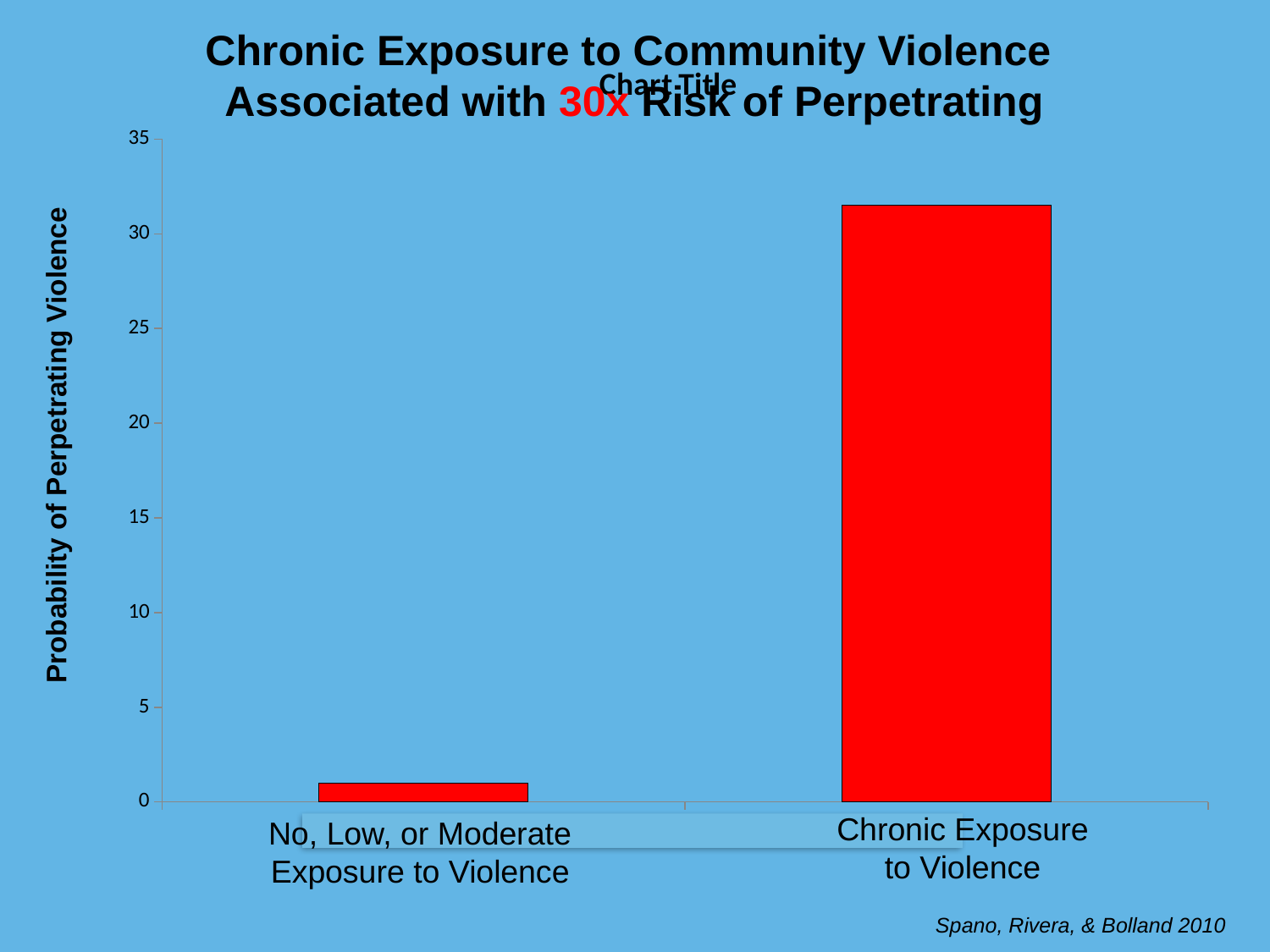
Is the value for No, Low, or Moderate Exposure to Violence greater or less than 5? less Is the value for Chronic Exposure to Violence greater or less than 30? greater How many categories are plotted on the x axis? 2 Which category has the lowest probability of perpetrating violence? No, Low, or Moderate Exposure to Violence Is the value for Chronic Exposure to Violence greater or less than 35? less What is the highest value shown on the vertical axis? 35 Do the values rise or fall moving from left to right along the x axis? rise What kind of chart is shown on the slide? bar chart Which category has the highest probability of perpetrating violence? Chronic Exposure to Violence What is the label on the vertical axis? Probability of Perpetrating Violence What colour are the bars in the chart? red Which is larger: the value for Chronic Exposure to Violence or the value for No, Low, or Moderate Exposure to Violence? Chronic Exposure to Violence